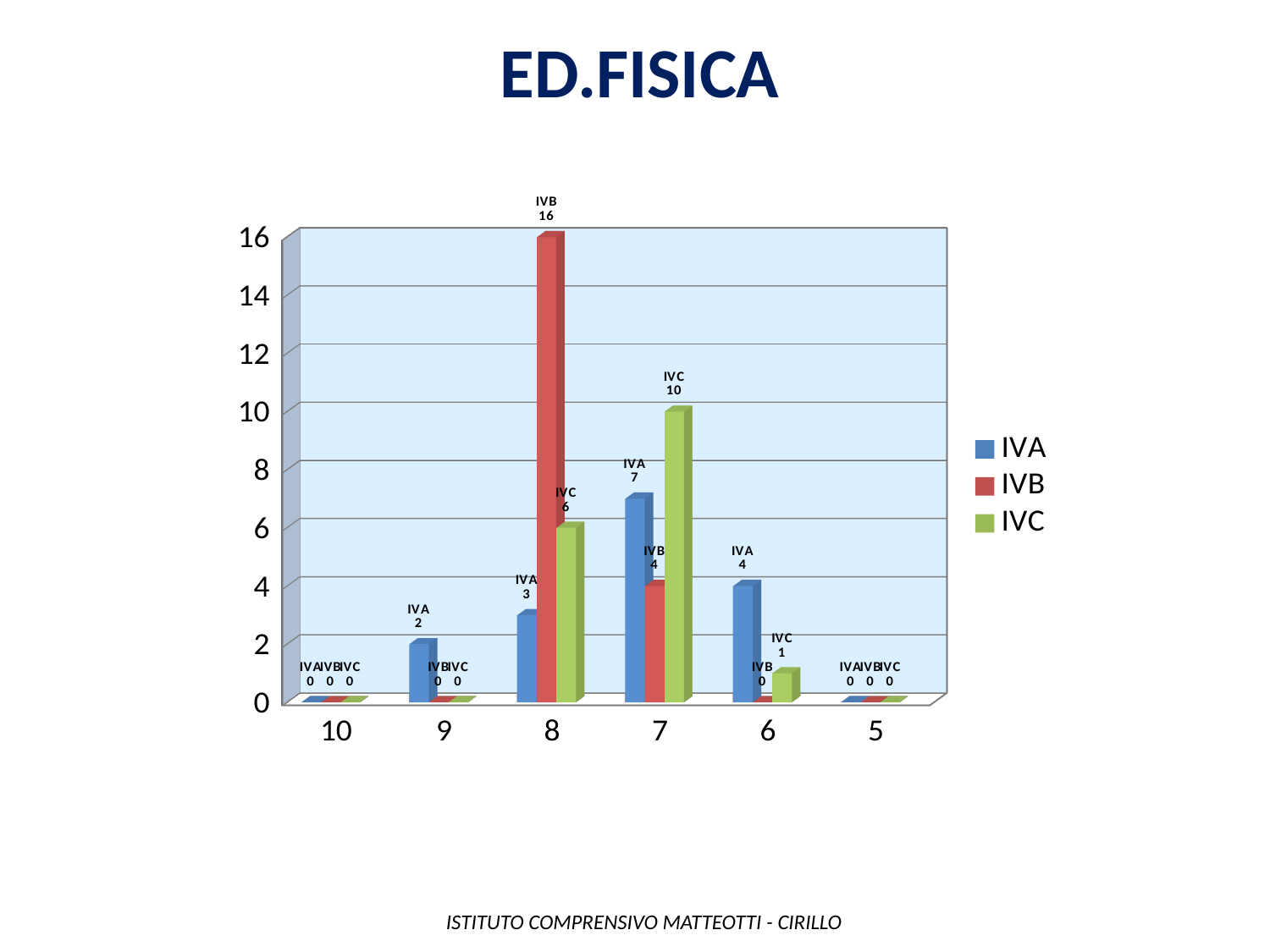
Which series has the highest value at grade 8? IVB What is the value for IVA at grade 9? 2 What kind of chart is shown on the slide? Bar chart What is the value for IVC at grade 6? 1 At which grade does IVA reach its highest value? 7 What is the difference between IVC and IVA at grade 7? 3 What is the difference between IVB and IVC at grade 8? 10 What is the value for IVC at grade 7? 10 How many grade categories are shown on the x axis? 6 How many series does the legend list? 3 What is the value for IVB at grade 8? 16 Which is larger at grade 6, IVA or IVC? IVA